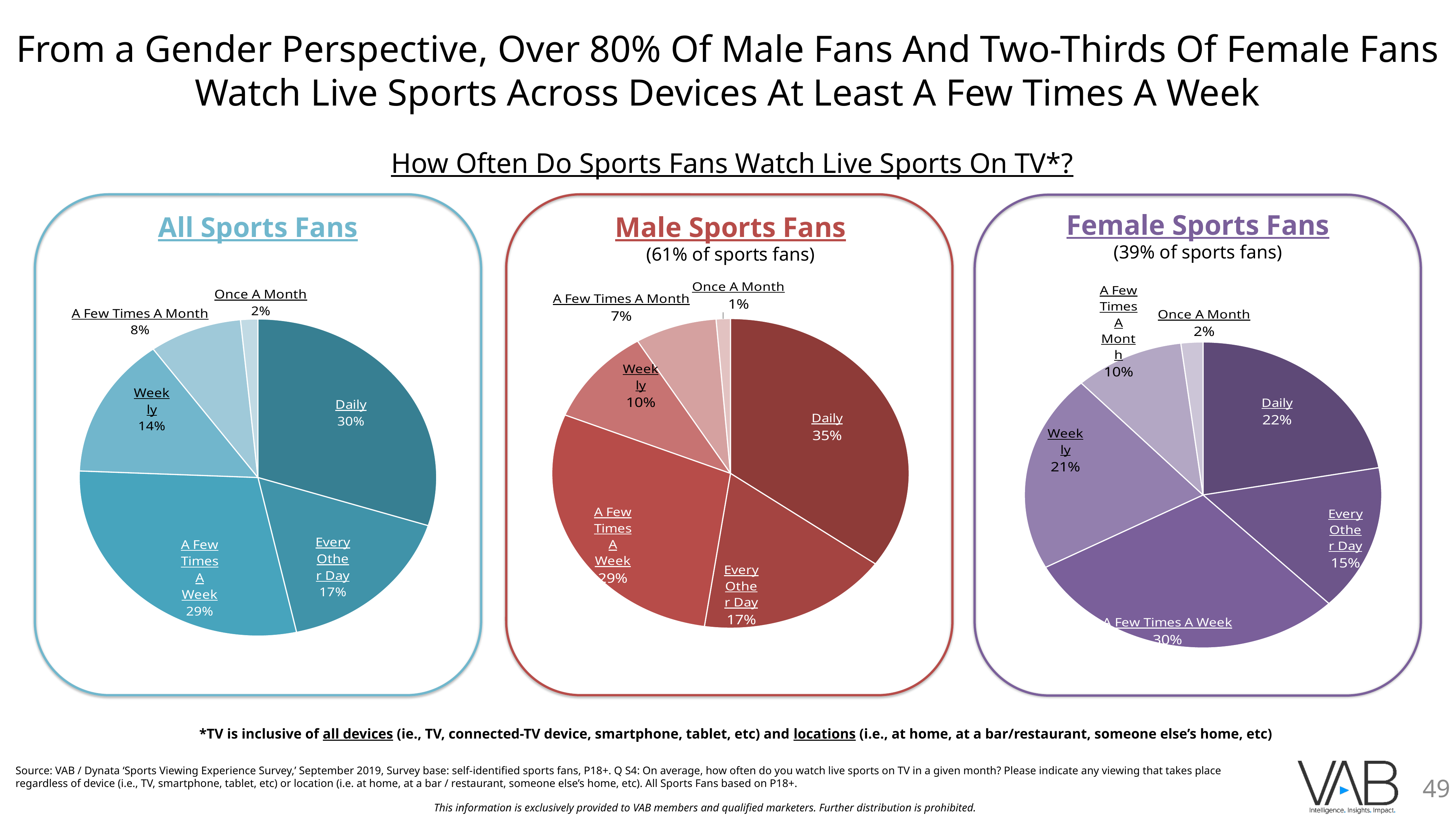
In the Male Sports Fans pie chart, what share of fans watch live sports on TV daily? 35% In the Female Sports Fans pie chart, what share of fans watch live sports on TV weekly? 21% In the Female Sports Fans pie chart, which category has the largest share? A Few Times A Week According to the Male Sports Fans chart subtitle, what percentage of sports fans are male? 61% What type of chart is used for the Male Sports Fans data? Pie chart In the Male Sports Fans pie chart, which category has the smallest share? Once A Month In the Male Sports Fans pie chart, what share of fans watch live sports on TV a few times a month? 7% Which is larger: the Daily share for Male Sports Fans or the Daily share for Female Sports Fans? Male Sports Fans How many categories does the All Sports Fans pie chart show? 6 In the All Sports Fans pie chart, what share of fans watch live sports on TV daily? 30% In the Female Sports Fans pie chart, what is the combined share of Daily and Every Other Day? 37% In the All Sports Fans pie chart, what is the difference between the Daily share and the Weekly share? 16%